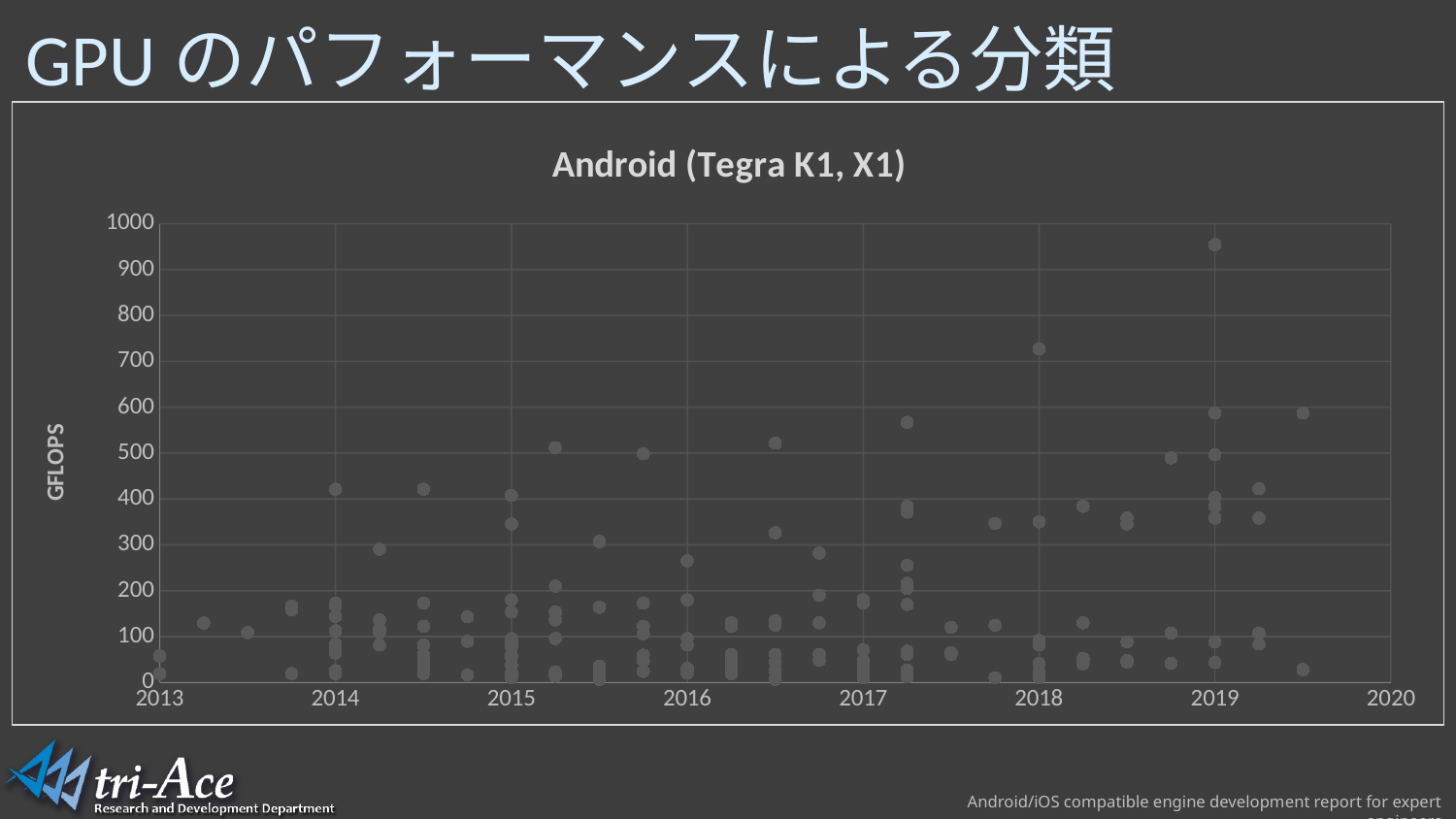
What kind of chart is shown on the slide? scatter chart In which year does the highest point on the chart appear? 2019 Do the highest GFLOPS values plotted generally rise or fall from 2013 to 2019? rise Which year has a higher maximum plotted value, 2018 or 2016? 2018 What is the label on the vertical axis of the chart? GFLOPS What is the title of the chart? Android (Tegra K1, X1) Is the highest point plotted in 2013 greater or less than 200 GFLOPS? less Is the highest point plotted in 2016 greater or less than 400 GFLOPS? greater Is the highest point plotted in 2017 greater or less than 500 GFLOPS? greater